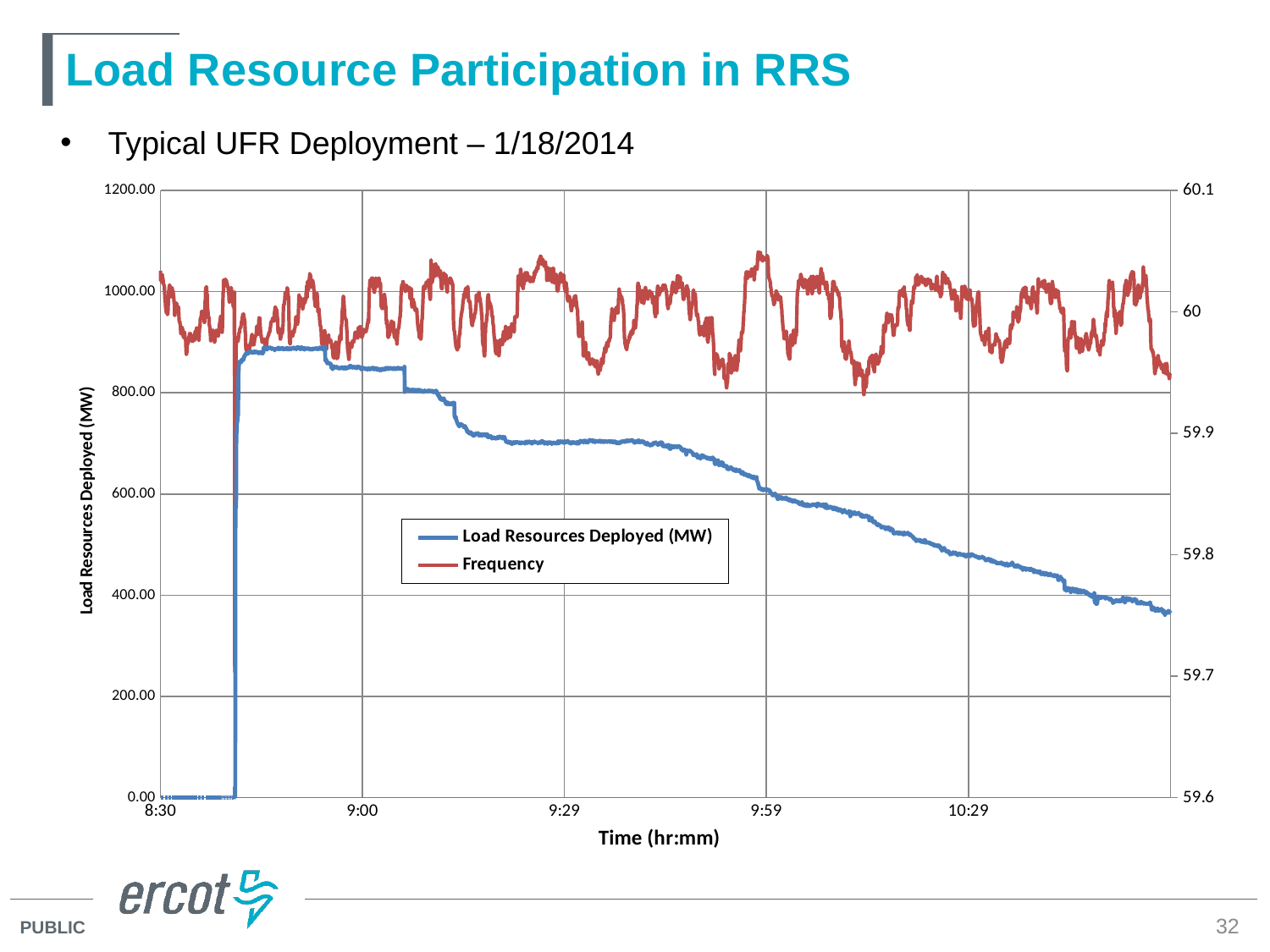
Is the value of Load Resources Deployed (MW) at 9:29 greater or less than 600? greater What are the two series named in the chart legend? Load Resources Deployed (MW) and Frequency What is the title of the x axis of the chart? Time (hr:mm) How many time labels are shown on the x axis of the chart? 5 After its initial jump shortly after 8:30, does the Load Resources Deployed (MW) series rise or fall over the rest of the time axis? fall Does the Frequency series ever rise above 60.1 on the right axis? No Is the value of Load Resources Deployed (MW) at 9:00 greater or less than 800? greater How many series does the chart legend list? 2 What kind of chart is shown on the slide? line chart